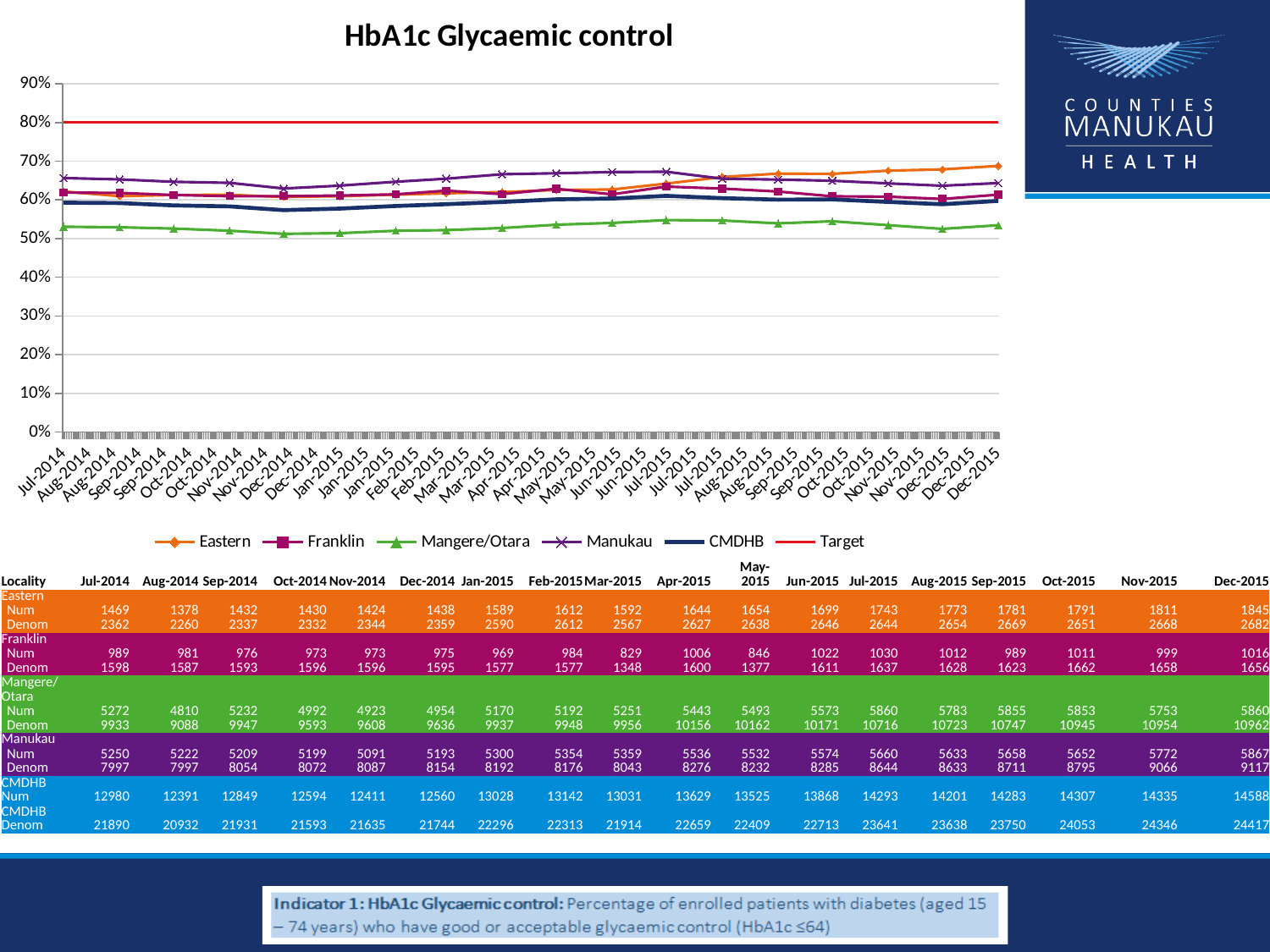
What colour is the Target line on the chart? red Is the value for CMDHB at Jul-2014 greater or less than 50%? greater Is the value for Mangere/Otara at Jul-2014 greater or less than 60%? less At what percentage is the Target line drawn on the chart? 80% What kind of chart is shown on the slide? line chart Is the value for Eastern at Dec-2015 greater or less than 60%? greater Which series has the highest value at Jul-2014? Manukau At Jul-2014, which is larger: Manukau or Mangere/Otara? Manukau How many series does the chart legend list? 6 Which series has the highest value at Dec-2015? Eastern Which series has the lowest values across the whole period shown? Mangere/Otara Does the Eastern series rise or fall over the course of 2015? rises